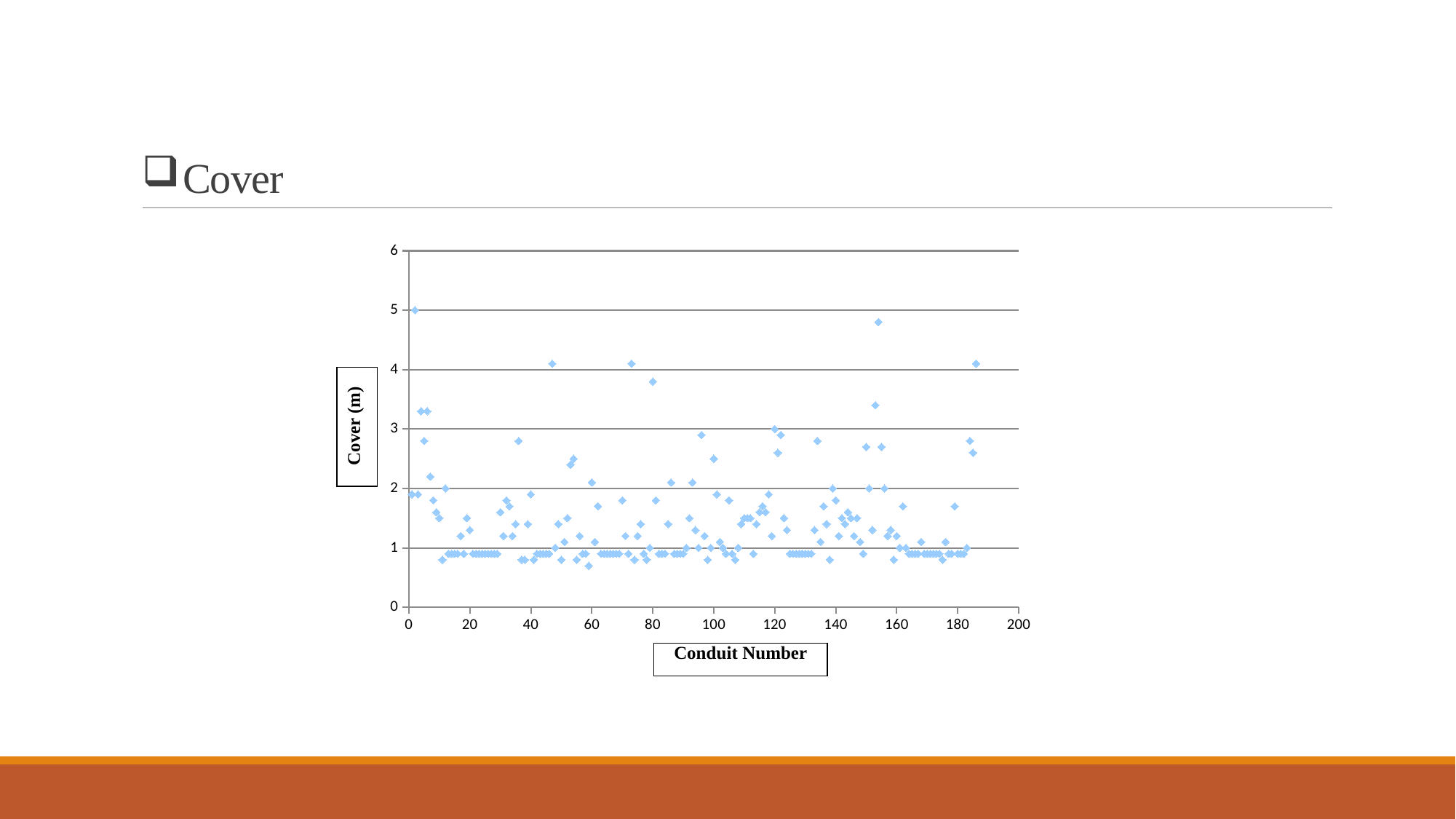
What is the title of the horizontal axis of the chart? Conduit Number Is the highest plotted cover value on the chart greater or less than 4? greater Is the cover value for the point near conduit number 80 greater or less than 3? greater What kind of chart is shown on the slide? scatter chart Is the lowest plotted cover value on the chart greater or less than 1? less What is the title of the vertical axis of the chart? Cover (m)